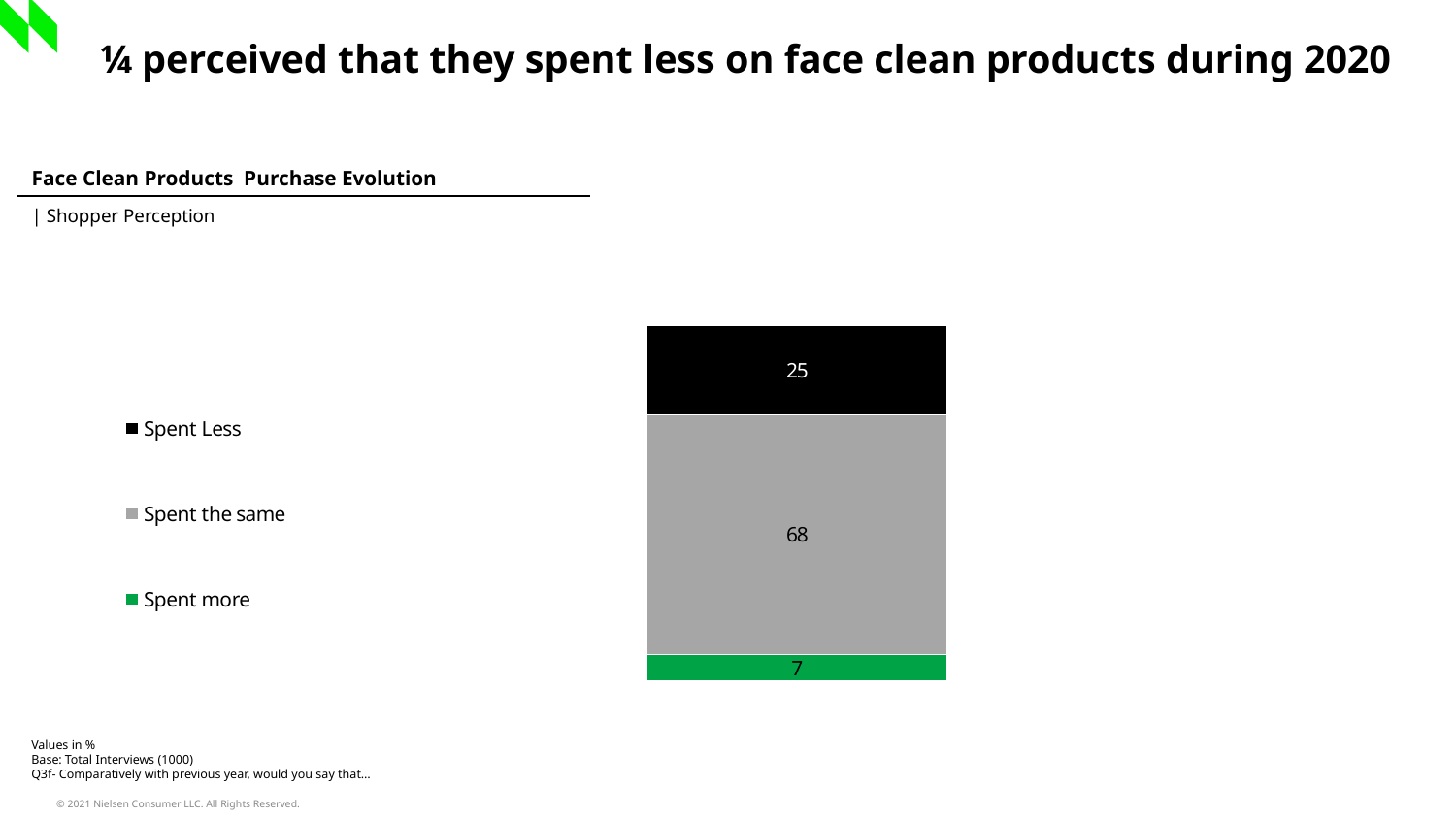
What value is shown for the 'Spent Less' segment of the stacked bar? 25 What value is shown for the 'Spent the same' segment? 68 What is the difference between the 'Spent the same' and 'Spent Less' values? 43 Which is larger, the value for 'Spent Less' or the value for 'Spent more'? Spent Less What kind of chart is shown on the slide? Stacked bar chart What is the difference between the 'Spent Less' and 'Spent more' values? 18 What is the total of the three segments in the stacked bar? 100 Which colour represents 'Spent more' in the legend? Green Which segment of the stacked bar has the smallest value? Spent more What value is shown for the 'Spent more' segment? 7 Which segment of the stacked bar has the largest value? Spent the same How many series does the legend list? 3